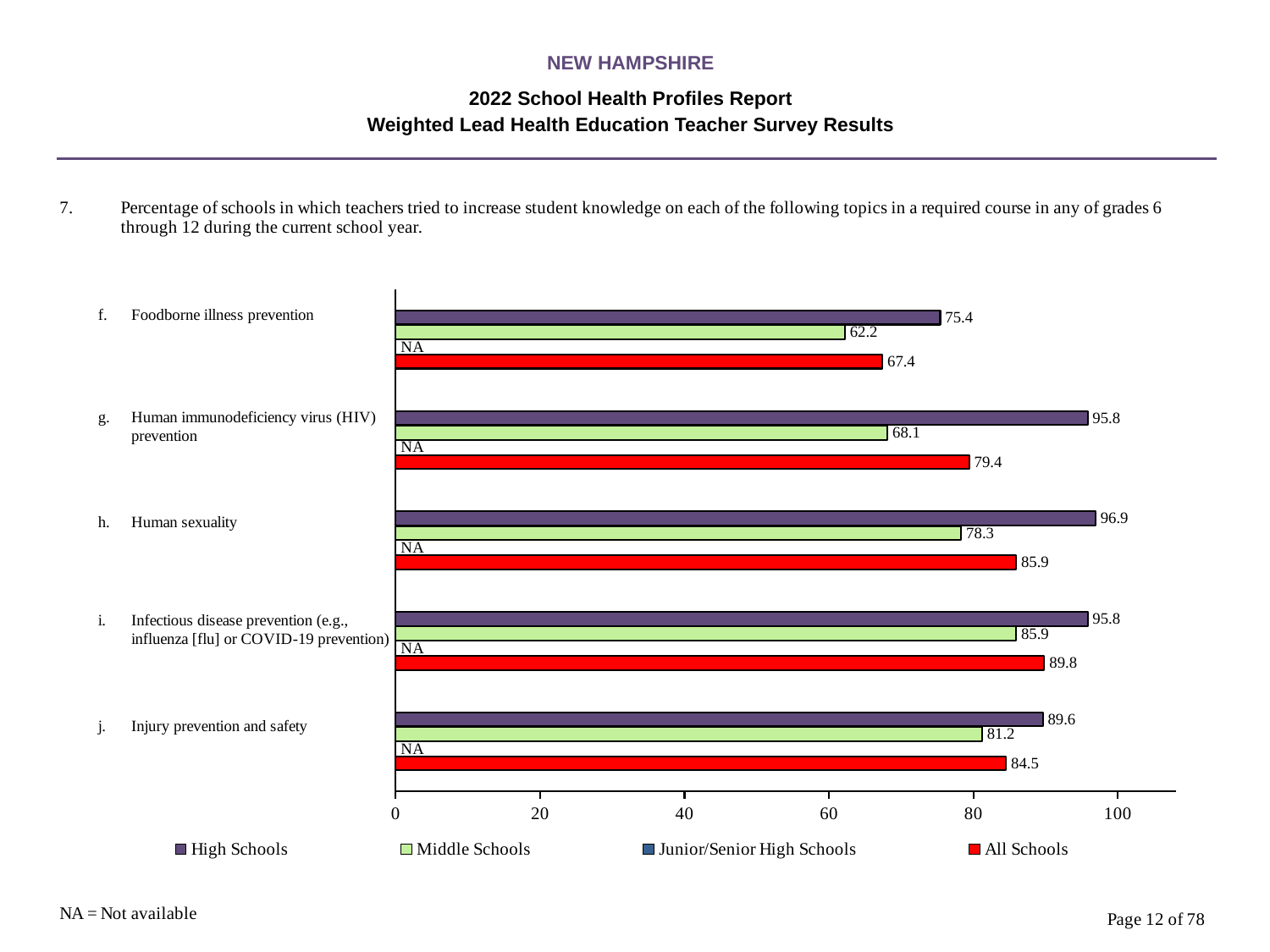
Is the All Schools value for Foodborne illness prevention greater or less than 80? less What value is shown for Junior/Senior High Schools for each topic? NA Which is larger for Infectious disease prevention: the Middle Schools value or the All Schools value? All Schools What is the All Schools value for Injury prevention and safety? 84.5 How many series does the legend list? 4 What is the High Schools value for Foodborne illness prevention? 75.4 Which topic has the lowest Middle Schools value? Foodborne illness prevention What kind of chart is shown? bar chart What is the difference between the High Schools and Middle Schools values for Human sexuality? 18.6 What is the Middle Schools value for Human immunodeficiency virus (HIV) prevention? 68.1 Which topic has the highest High Schools value? Human sexuality How many topics are shown on the chart? 5